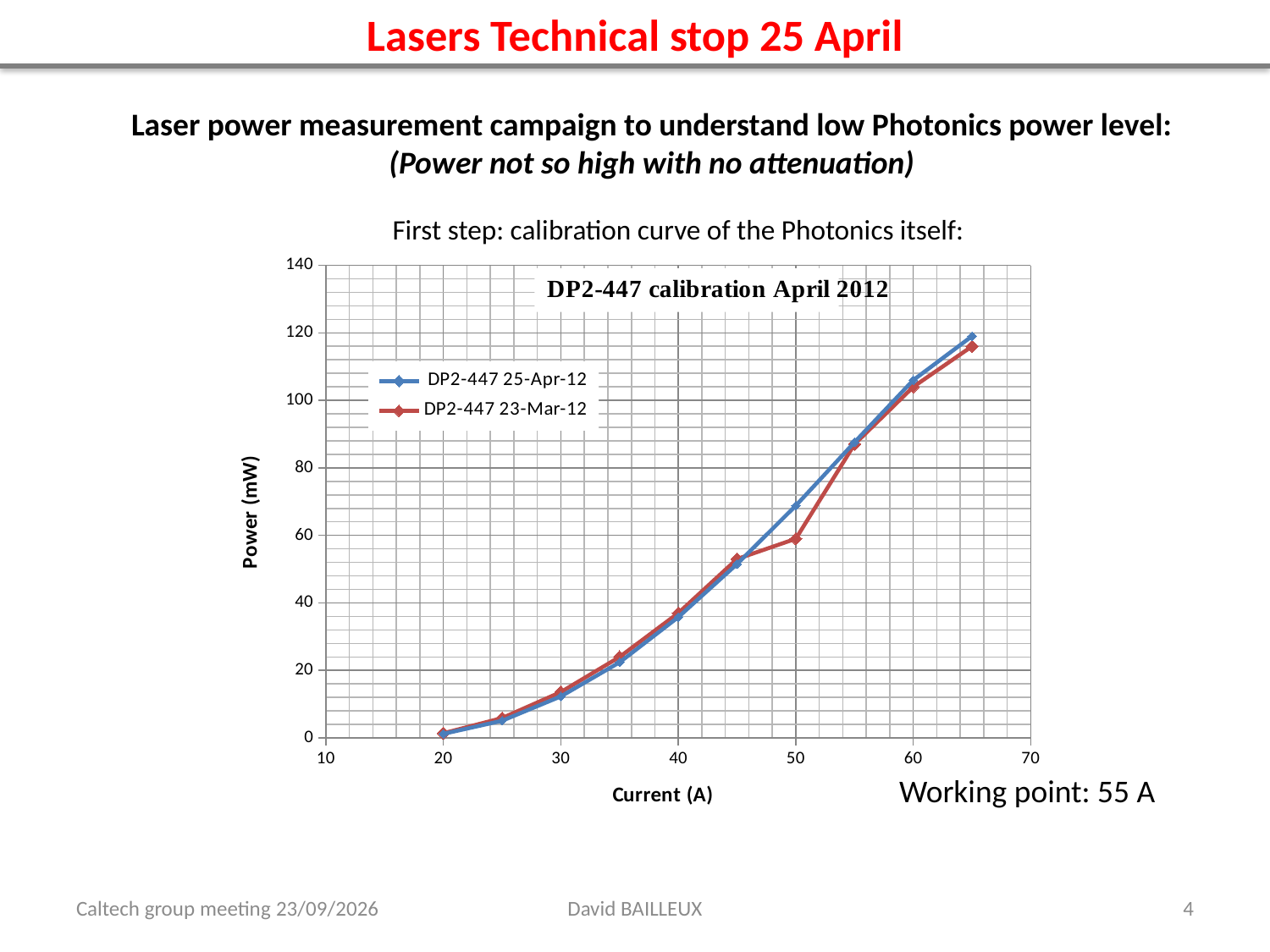
What is the title of the chart? DP2-447 calibration April 2012 Is the value for DP2-447 23-Mar-12 at 30 A greater or less than 20? less Is the value for DP2-447 25-Apr-12 at 50 A greater or less than 60? greater At which current does the DP2-447 23-Mar-12 series have its lowest power? 20 Does the power rise or fall as the current increases along the x axis? rise What is the label of the y axis of the chart? Power (mW) How many data points are plotted for the DP2-447 25-Apr-12 series? 10 What kind of chart is shown on the slide? line chart How many series does the chart legend list? 2 At which current does the DP2-447 25-Apr-12 series reach its highest power? 65 Is the value for DP2-447 25-Apr-12 at 60 A greater or less than 100? greater At 50 A, which series has the higher power, DP2-447 25-Apr-12 or DP2-447 23-Mar-12? DP2-447 25-Apr-12